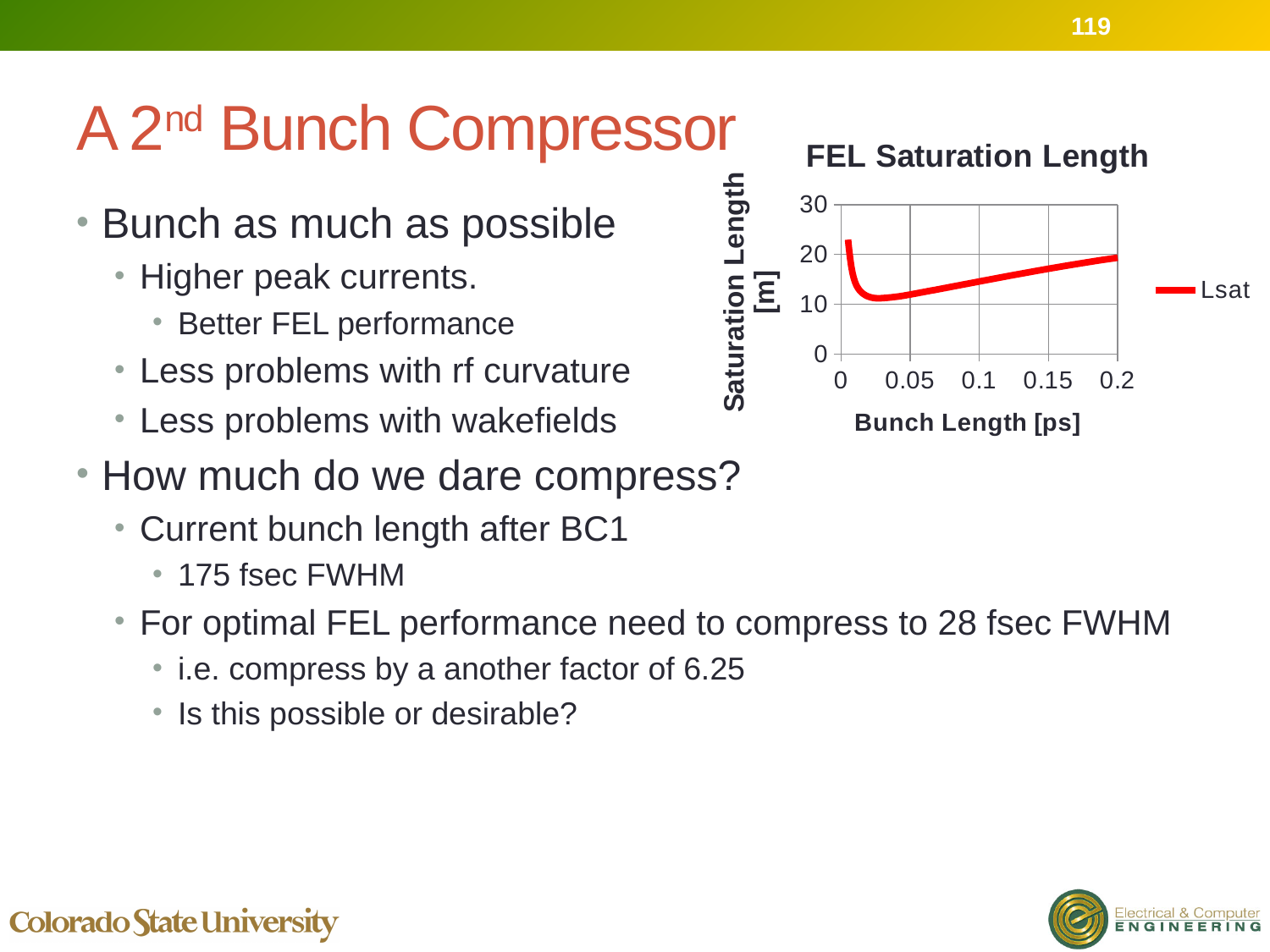
What is the highest value shown on the y-axis of the FEL Saturation Length chart? 30 In the FEL Saturation Length chart, is the value of Lsat at a bunch length of 0.1 ps greater or less than 20? less In the FEL Saturation Length chart, is the value of Lsat larger at a bunch length of 0.2 ps or at 0.05 ps? 0.2 ps How many series does the legend of the FEL Saturation Length chart list? 1 In the FEL Saturation Length chart, is the value of Lsat at a bunch length of 0.2 ps greater or less than 10? greater What is the x-axis label of the FEL Saturation Length chart? Bunch Length [ps] What kind of chart is the FEL Saturation Length chart? line chart In the FEL Saturation Length chart, is the value of Lsat at a bunch length of 0.05 ps greater or less than 20? less In the FEL Saturation Length chart, does the Lsat curve rise or fall as bunch length increases from 0.05 ps to 0.2 ps? rise What is the name of the series shown in the legend of the FEL Saturation Length chart? Lsat